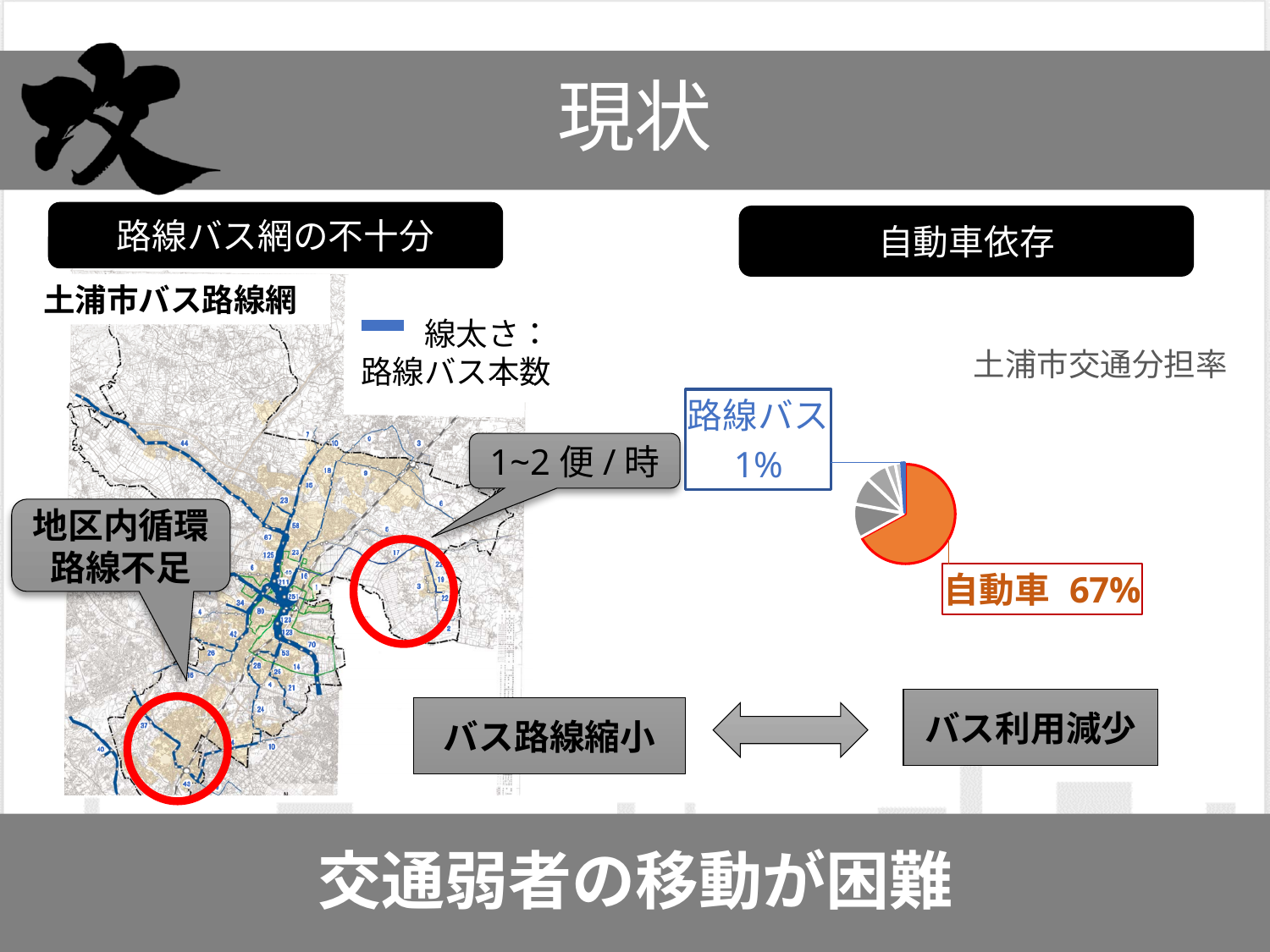
In the pie chart 土浦市交通分担率, what colour is the 自動車 slice? orange In the pie chart 土浦市交通分担率, which labelled category has the smallest slice? 路線バス In the pie chart 土浦市交通分担率, which labelled category has the largest slice? 自動車 What kind of chart is shown under the heading 自動車依存? pie chart In the pie chart 土浦市交通分担率, what share is labelled for 自動車? 67% In the pie chart 土浦市交通分担率, what share is labelled for 路線バス? 1% In the pie chart 土浦市交通分担率, which is larger, the share for 自動車 or the share for 路線バス? 自動車 What is the title of the pie chart on the right side of the slide? 土浦市交通分担率 In the pie chart 土浦市交通分担率, what is the difference in percentage points between the 自動車 share and the 路線バス share? 66